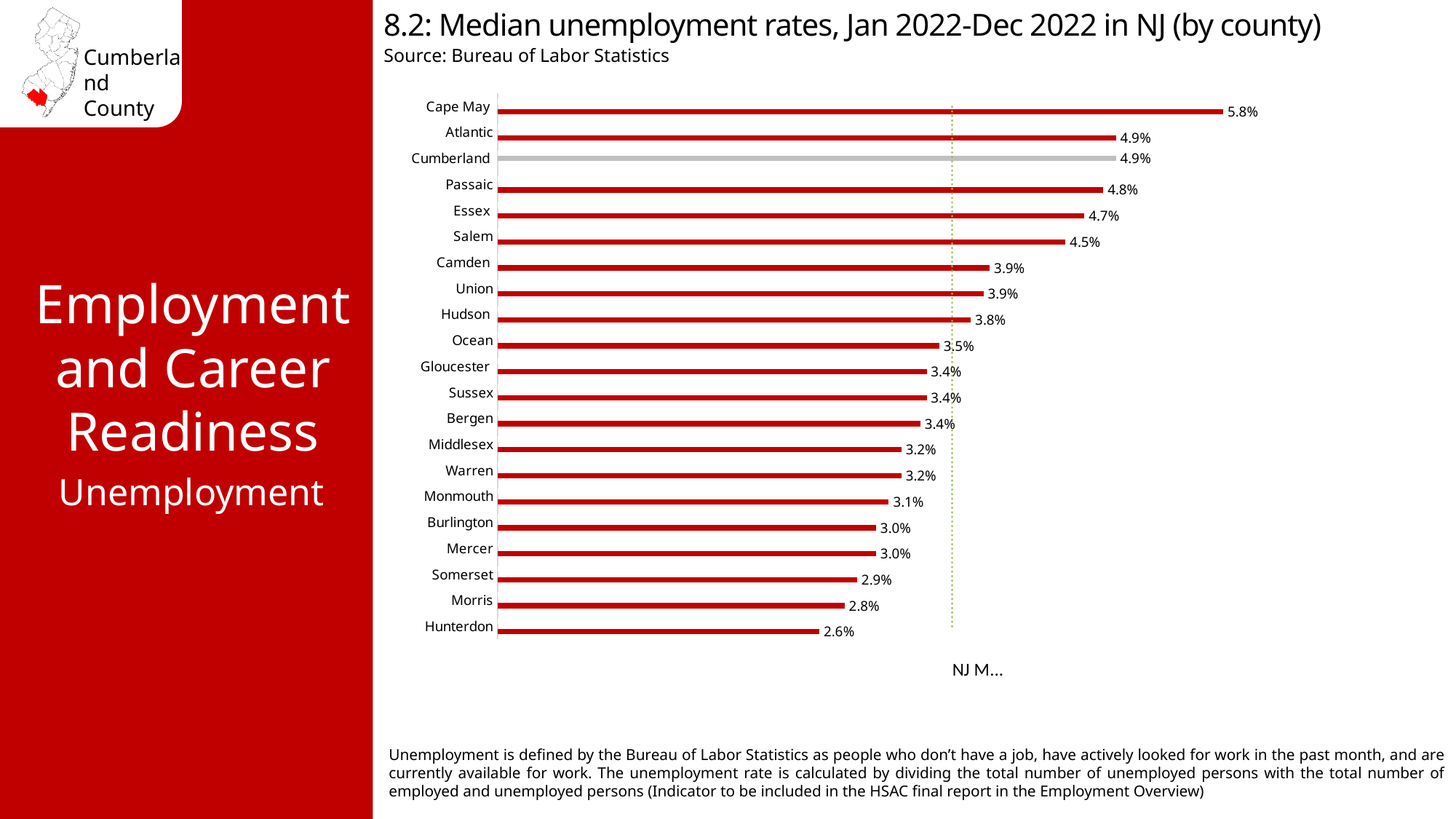
What is the median unemployment rate for Salem County? 4.5% What kind of chart is shown on the slide? Bar chart Which county has a higher median unemployment rate, Morris or Somerset? Somerset What is the difference between the median unemployment rates of Cumberland and Camden? 1.0 percentage point What is the median unemployment rate for Hudson County? 3.8% Which county has the highest median unemployment rate? Cape May Which county has a higher median unemployment rate, Passaic or Salem? Passaic What is the median unemployment rate for Cumberland County? 4.9% Which county has the lowest median unemployment rate? Hunterdon How many counties are shown in the chart? 21 What is the difference between the median unemployment rates of Cape May and Hunterdon? 3.2 percentage points Which county's bar is coloured grey instead of red? Cumberland